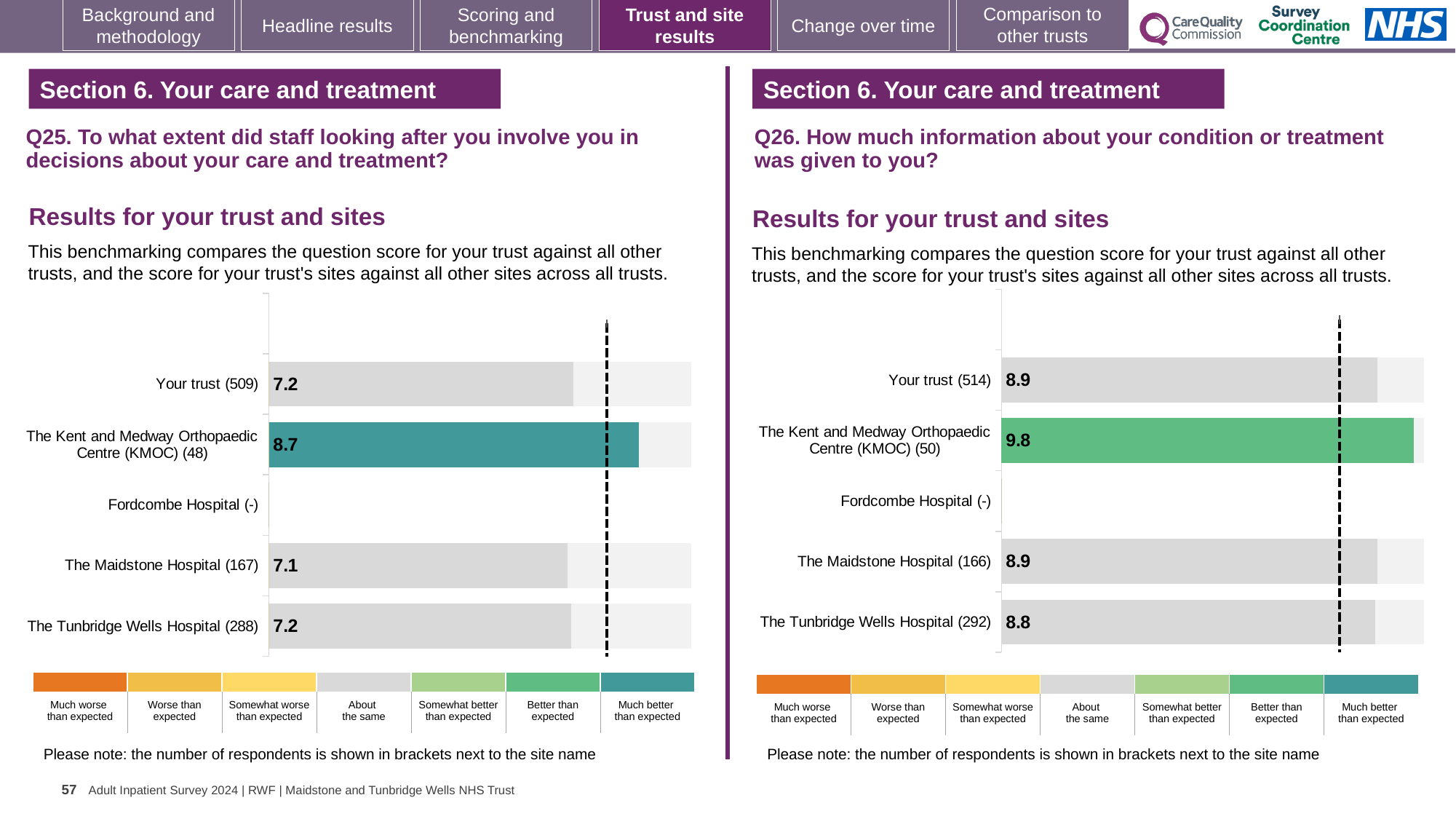
On the Q26 chart (right), what is the difference between the score for The Kent and Medway Orthopaedic Centre (KMOC) and the score for Your trust? 0.9 On the Q25 chart (left), what is the score for The Kent and Medway Orthopaedic Centre (KMOC)? 8.7 On the Q26 chart (right), what is the score for The Kent and Medway Orthopaedic Centre (KMOC)? 9.8 On the Q25 chart (left), what is the difference between the score for The Kent and Medway Orthopaedic Centre (KMOC) and the score for The Maidstone Hospital? 1.6 What kind of chart is used on the Q26 chart (right)? Bar chart On the Q25 chart (left), which site has the lowest score? The Maidstone Hospital On the Q26 chart (right), which site has the highest score? The Kent and Medway Orthopaedic Centre (KMOC) On the Q25 chart (left), how many respondents are shown for The Tunbridge Wells Hospital? 288 On the Q26 chart (right), what is the score for The Tunbridge Wells Hospital? 8.8 On the Q25 chart (left), which site has the highest score? The Kent and Medway Orthopaedic Centre (KMOC) On the Q25 chart (left), what is the score for Your trust? 7.2 On the Q26 chart (right), which has the larger score, Your trust or The Tunbridge Wells Hospital? Your trust